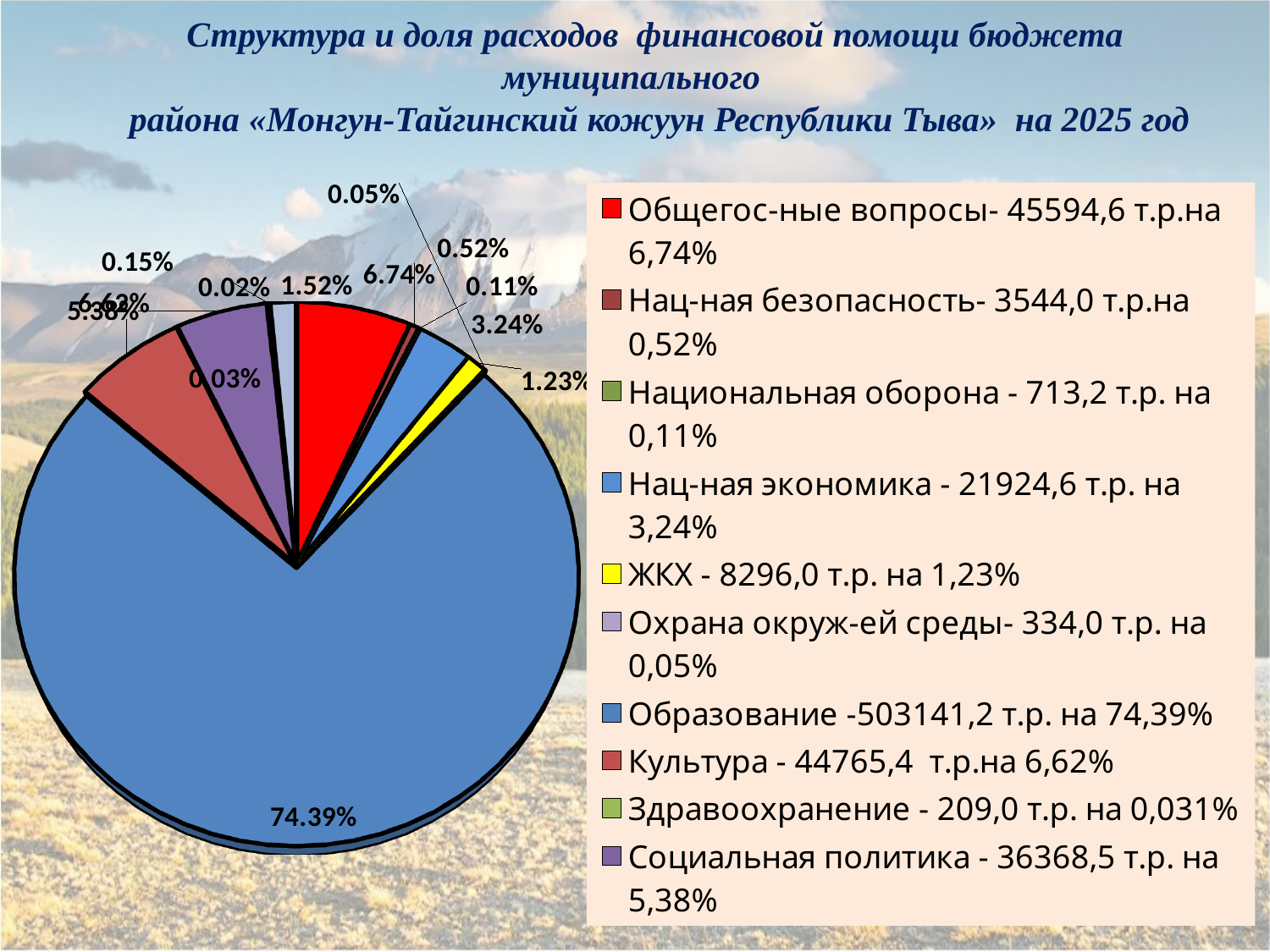
Which has the larger share: Общегос-ные вопросы or Культура? Общегос-ные вопросы What colour is the ЖКХ slice in the pie chart? yellow According to the legend, what amount is allocated to Образование? 503141,2 т.р. What share of the pie does ЖКХ account for? 1.23% What share of the pie does Нац-ная экономика account for? 3.24% What is the difference in percentage points between the shares of Нац-ная экономика and ЖКХ? 2.01% What is the difference in percentage points between the shares of Образование and Общегос-ные вопросы? 67.65% What share of the pie does Образование account for? 74.39% How many entries does the legend list? 10 Which category has the largest share of the pie? Образование According to the legend, what amount is allocated to Культура? 44765,4 т.р. What kind of chart is shown on the slide? pie chart